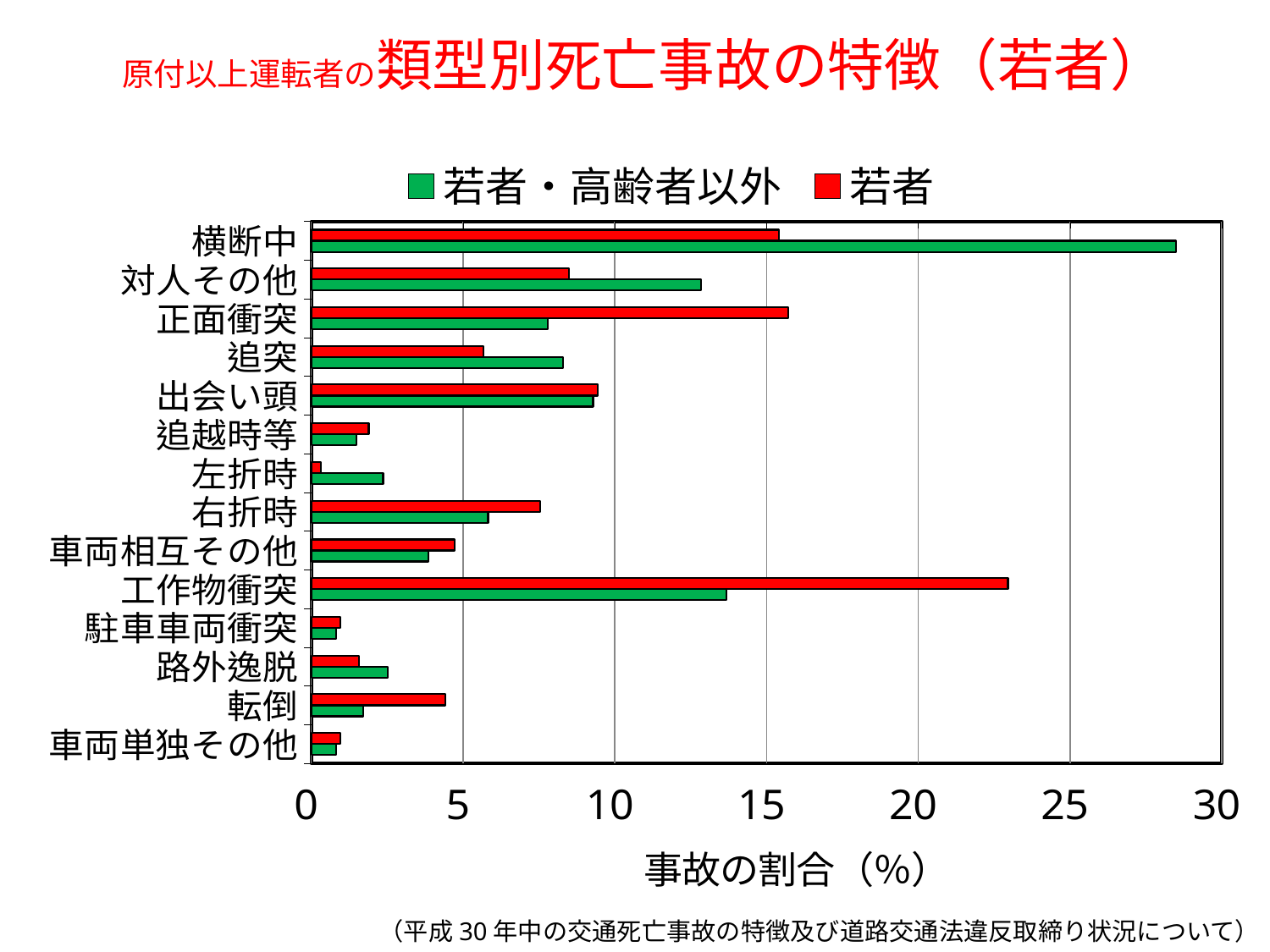
Is the 若者・高齢者以外 value for 追突 greater or less than 10? less Which category has the lowest value for the 若者 series? 左折時 How many series does the legend list? 2 For 正面衝突, which series has the larger value, 若者 or 若者・高齢者以外? 若者 Which category has the highest value for the 若者 series? 工作物衝突 Which category has the highest value for the 若者・高齢者以外 series? 横断中 What is the title of the horizontal axis? 事故の割合（%） Is the 若者 value for 工作物衝突 greater or less than 20? greater Which colour represents the 若者 series? red How many accident-type categories are shown on the vertical axis? 14 For 横断中, which series has the larger value, 若者 or 若者・高齢者以外? 若者・高齢者以外 What kind of chart is shown on the slide? bar chart